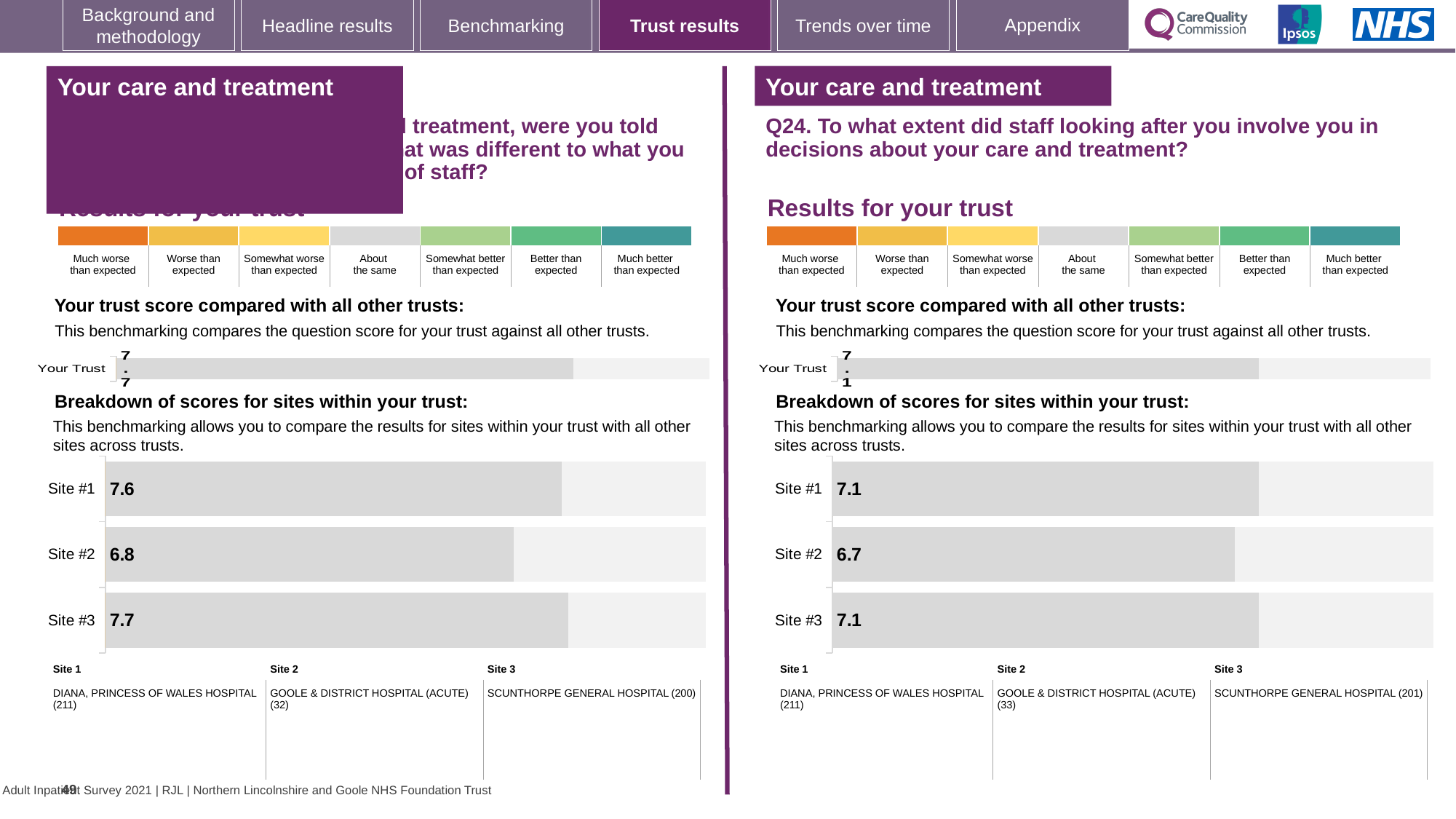
On the left-hand chart, what is the score shown for Site #1? 7.6 On the left-hand chart, what is the score shown for Your Trust? 7.7 On the left-hand chart, what is the difference between the scores for Site #3 and Site #2? 0.9 On the right-hand chart (Q24), what is the score shown for Site #3? 7.1 On the right-hand chart (Q24), what is the score shown for Site #2? 6.7 On the right-hand chart (Q24), which site has the lowest score? Site #2 How many sites are shown in the breakdown chart on the right-hand side (Q24)? 3 What type of chart is used for the breakdown of scores for sites on the left-hand side? Bar chart On the left-hand chart, which site has the highest score? Site #3 On the left-hand chart, which site has the lowest score? Site #2 On the left-hand chart, what is the score shown for Site #2? 6.8 On the right-hand chart (Q24), what is the difference between the scores for Site #1 and Site #2? 0.4